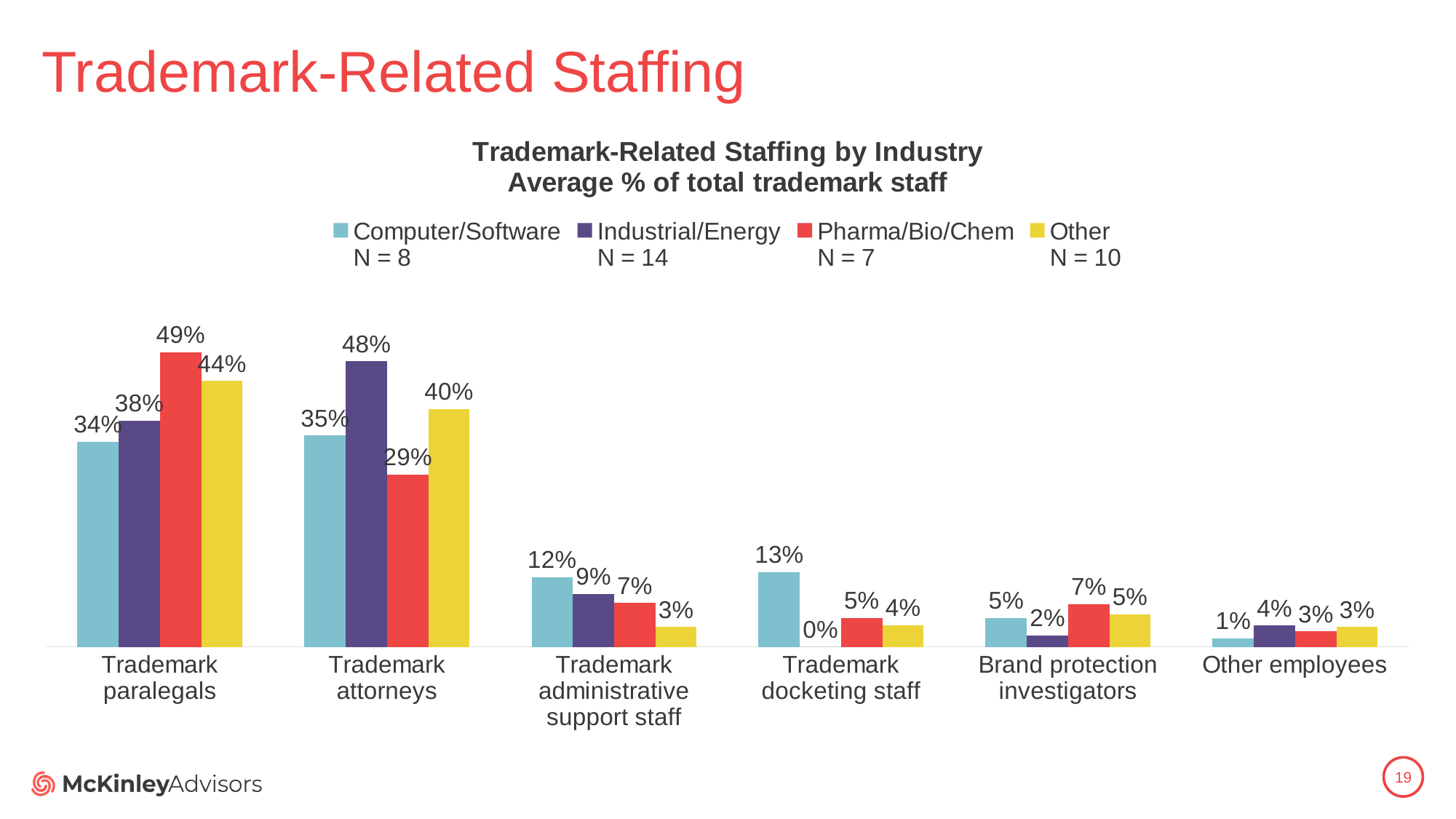
What is the value for Industrial/Energy for Trademark attorneys? 48% Which industry has the highest value for Trademark attorneys? Industrial/Energy How many staff categories are shown on the x axis? 6 What is the sample size (N) for the Industrial/Energy series in the legend? N = 14 What is the value for Computer/Software for Trademark docketing staff? 13% What is the difference between the Pharma/Bio/Chem and Computer/Software values for Trademark paralegals? 15% Which industry has the lowest value for Trademark paralegals? Computer/Software Which is larger for Trademark administrative support staff: Computer/Software or Other? Computer/Software What kind of chart is shown on the slide? Bar chart What is the value for Industrial/Energy for Trademark docketing staff? 0% What is the value for Pharma/Bio/Chem for Trademark paralegals? 49% How many series does the legend list? 4